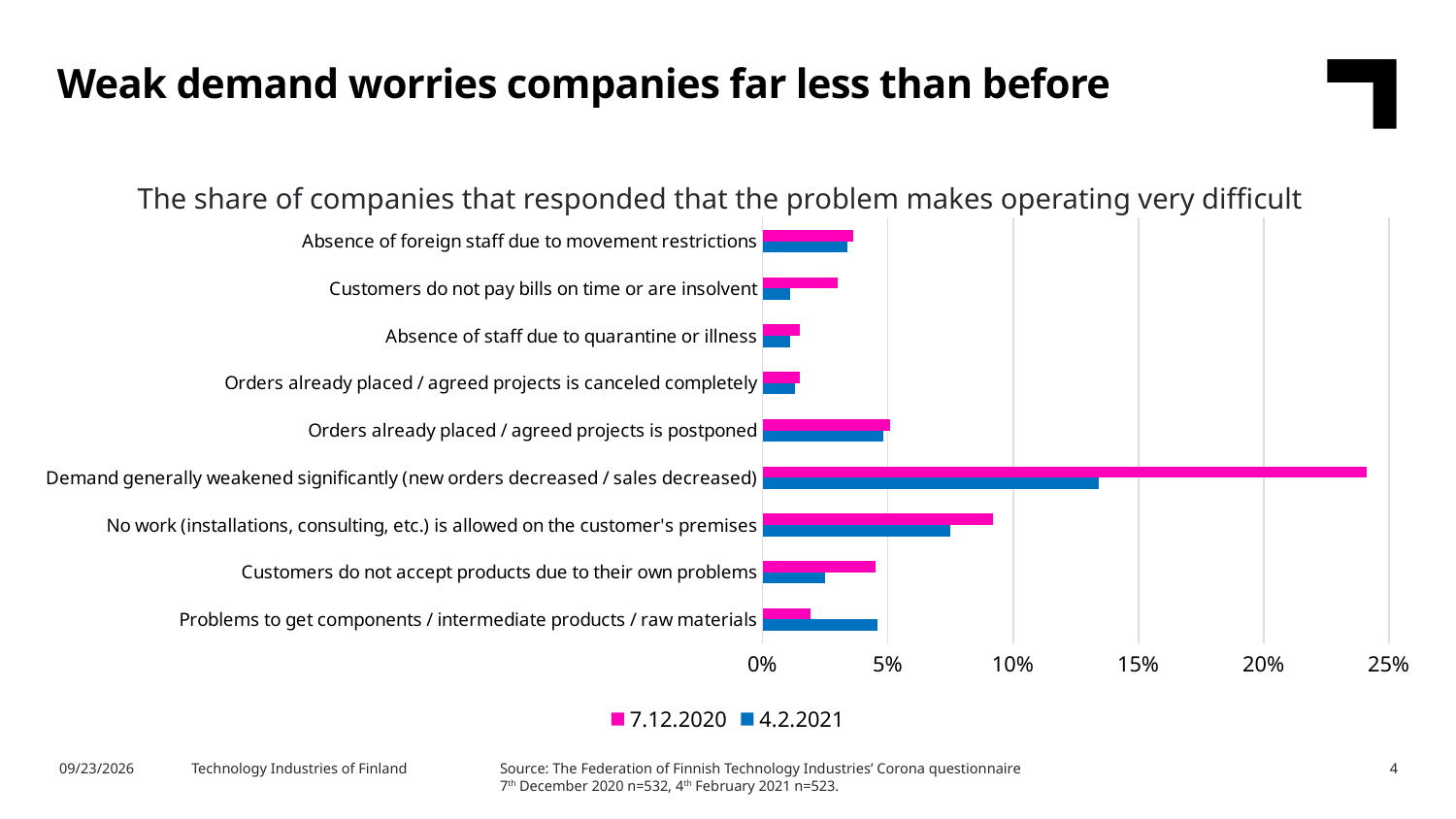
Is the 4.2.2021 value for 'Demand generally weakened significantly (new orders decreased / sales decreased)' greater or less than 10%? greater Which category has the highest value for the 4.2.2021 series? Demand generally weakened significantly (new orders decreased / sales decreased) For 'Customers do not accept products due to their own problems', which series has the larger value, 7.12.2020 or 4.2.2021? 7.12.2020 Is the 7.12.2020 value for 'Demand generally weakened significantly (new orders decreased / sales decreased)' greater or less than 20%? greater Is the 7.12.2020 value for 'No work (installations, consulting, etc.) is allowed on the customer's premises' greater or less than 10%? less For 'Problems to get components / intermediate products / raw materials', which series has the larger value, 7.12.2020 or 4.2.2021? 4.2.2021 What kind of chart is shown on the slide? Bar chart How many problem categories are plotted on the chart? 9 Which colour represents the 4.2.2021 series in the chart? Blue How many series does the chart legend list? 2 Which category has the highest value for the 7.12.2020 series? Demand generally weakened significantly (new orders decreased / sales decreased)